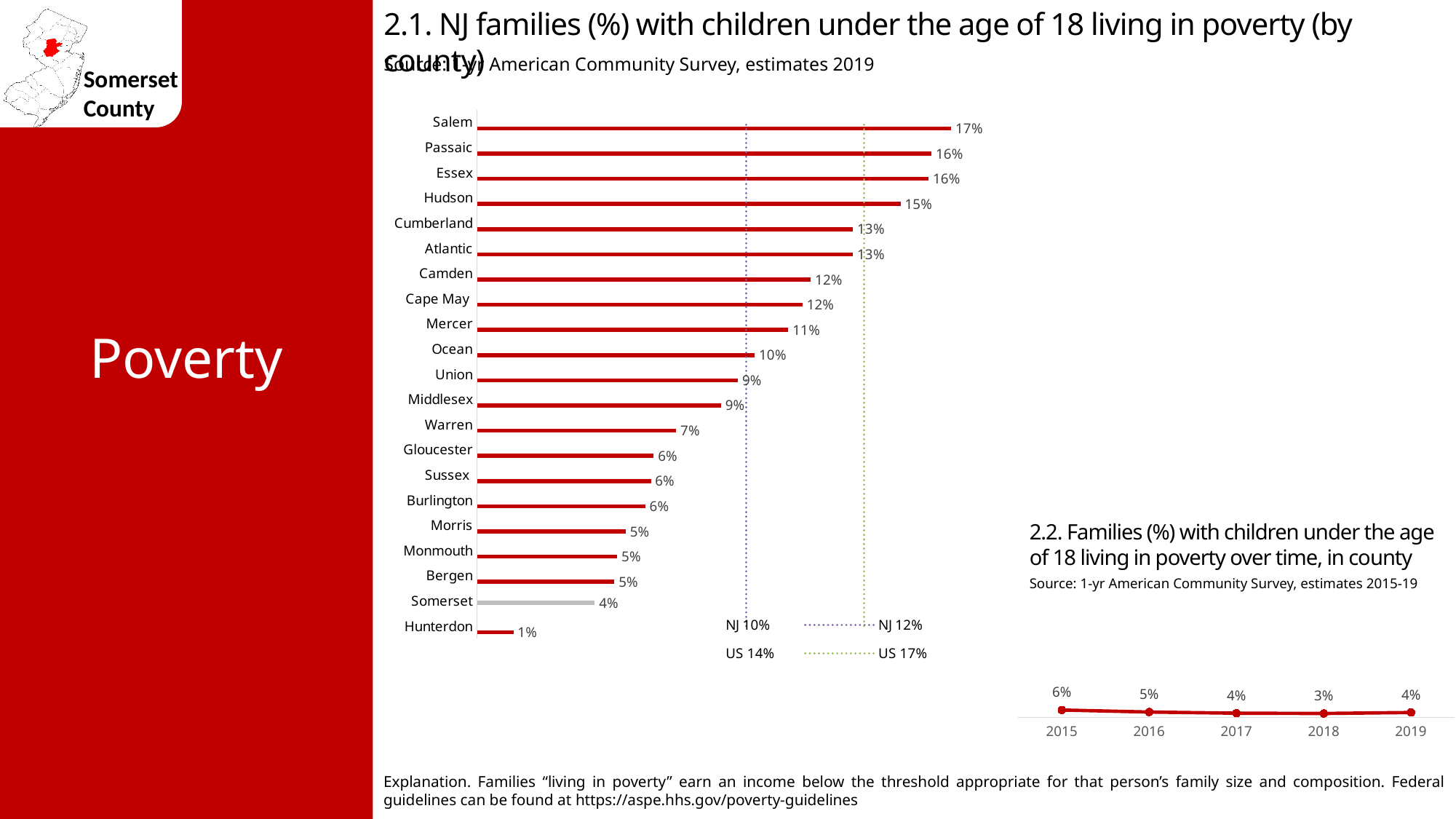
In chart 2.1, what percentage of families with children under 18 live in poverty in Somerset County? 4% In chart 2.2, what was the percentage of families with children living in poverty in 2018? 3% In chart 2.1, what is the value shown for Hudson? 15% In chart 2.1, which county has the highest percentage of families with children living in poverty? Salem In chart 2.2, which year has the highest value? 2015 In chart 2.2, what is the difference between the 2015 and 2019 values? 2 percentage points What type of chart is chart 2.1? Bar chart In chart 2.1, which has a higher value, Mercer or Warren? Mercer In chart 2.1, which county has the lowest percentage of families with children living in poverty? Hunterdon In chart 2.1, what is the difference between the values for Salem and Somerset? 13 percentage points How many counties are shown in chart 2.1? 21